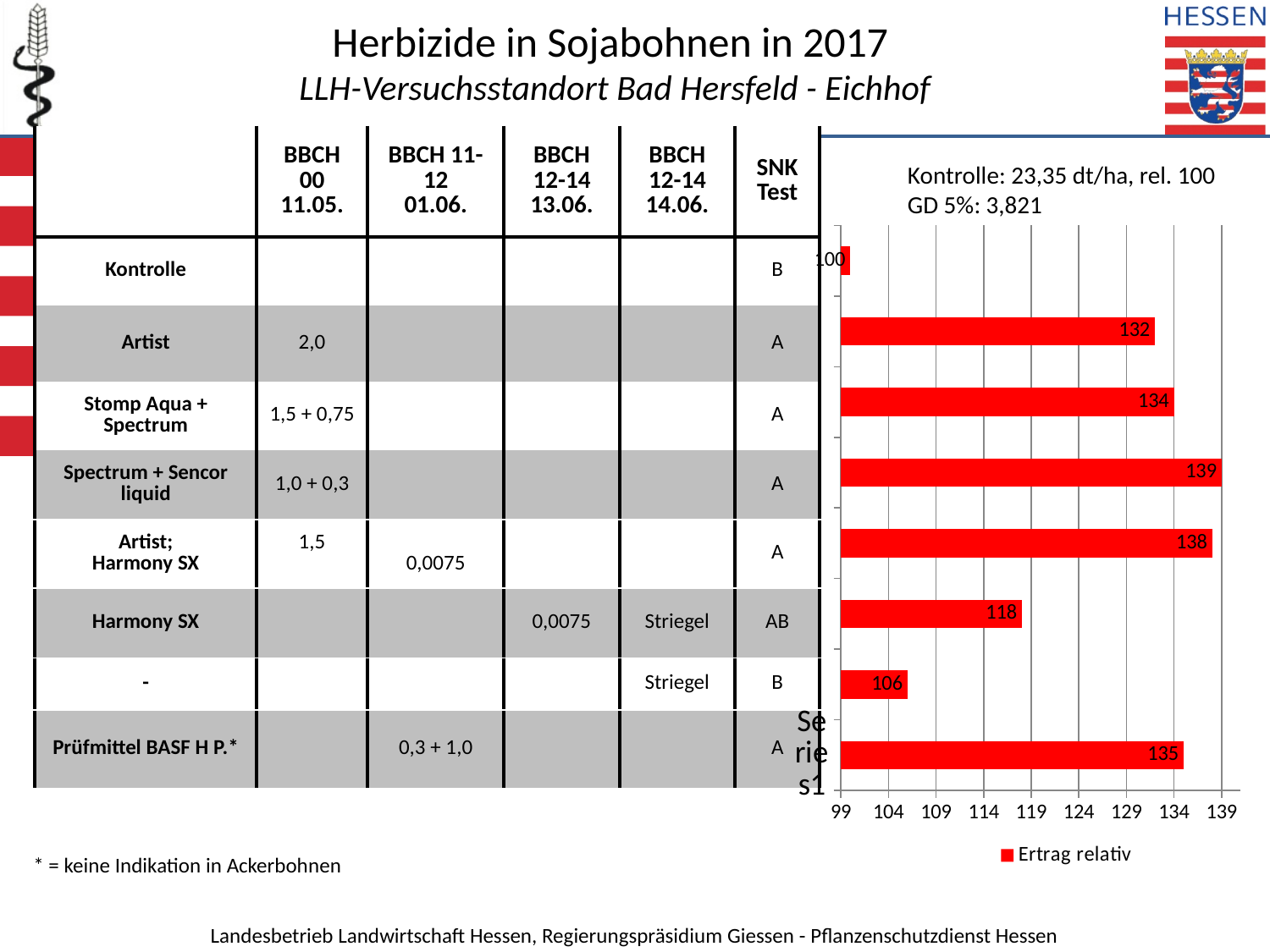
Which bar is longer: the one aligned with the Artist row (132) or the one aligned with the Stomp Aqua + Spectrum row (134)? Stomp Aqua + Spectrum What is the value of the bottom bar in the chart (the Prüfmittel BASF H P.* row)? 135 What is the value of the topmost bar in the chart (the Kontrolle row)? 100 What is the name of the series shown in the chart legend? Ertrag relativ What is the difference between the bar aligned with the Artist; Harmony SX row (138) and the bar aligned with the Harmony SX row (118)? 20 What is the highest value shown in the chart? 139 What is the difference between the highest bar value (139) and the lowest bar value (100)? 39 What is the value of the bar aligned with the Harmony SX row? 118 What kind of chart is shown on the right side of the slide? bar chart What is the lowest value shown in the chart? 100 How many bars does the chart contain? 8 How many series does the chart legend list? 1